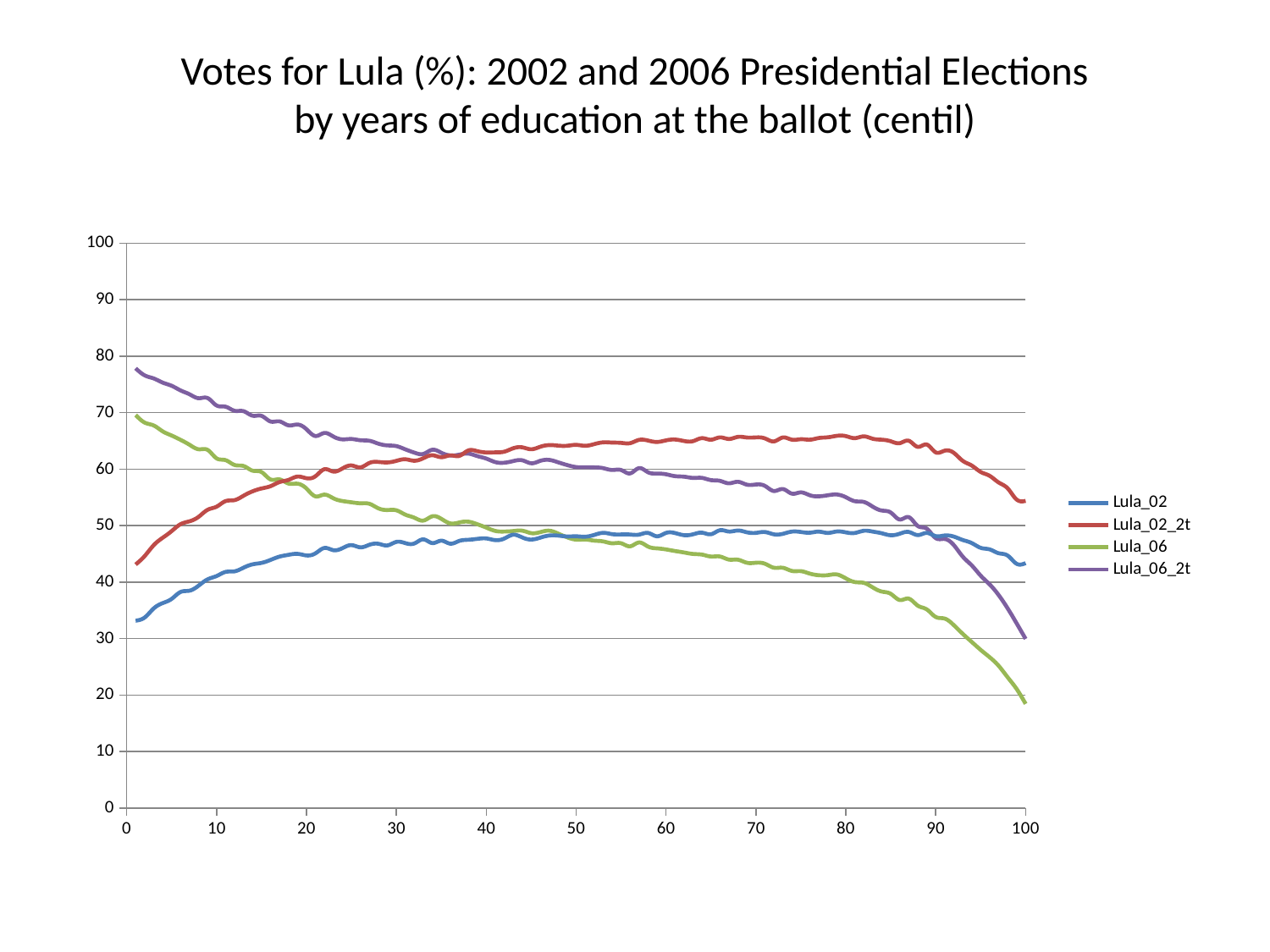
What colour is the Lula_02 line? blue Is the value of Lula_02 at centil 1 greater or less than 40? less Is the value of Lula_06 at centil 100 greater or less than 20? less Does the Lula_06 line rise or fall as the centil increases from 0 to 100? fall What kind of chart is shown on the slide? line chart What are the four series named in the legend? Lula_02, Lula_02_2t, Lula_06, Lula_06_2t Is the value of Lula_06_2t at centil 1 greater or less than 70? greater Which series has the lowest value at centil 100? Lula_06 At centil 10, which series has the higher value, Lula_06_2t or Lula_02? Lula_06_2t How many series does the legend list? 4 Does the Lula_06_2t line rise or fall as the centil increases from 0 to 100? fall Does the Lula_02_2t line rise or fall between centil 0 and centil 40? rise